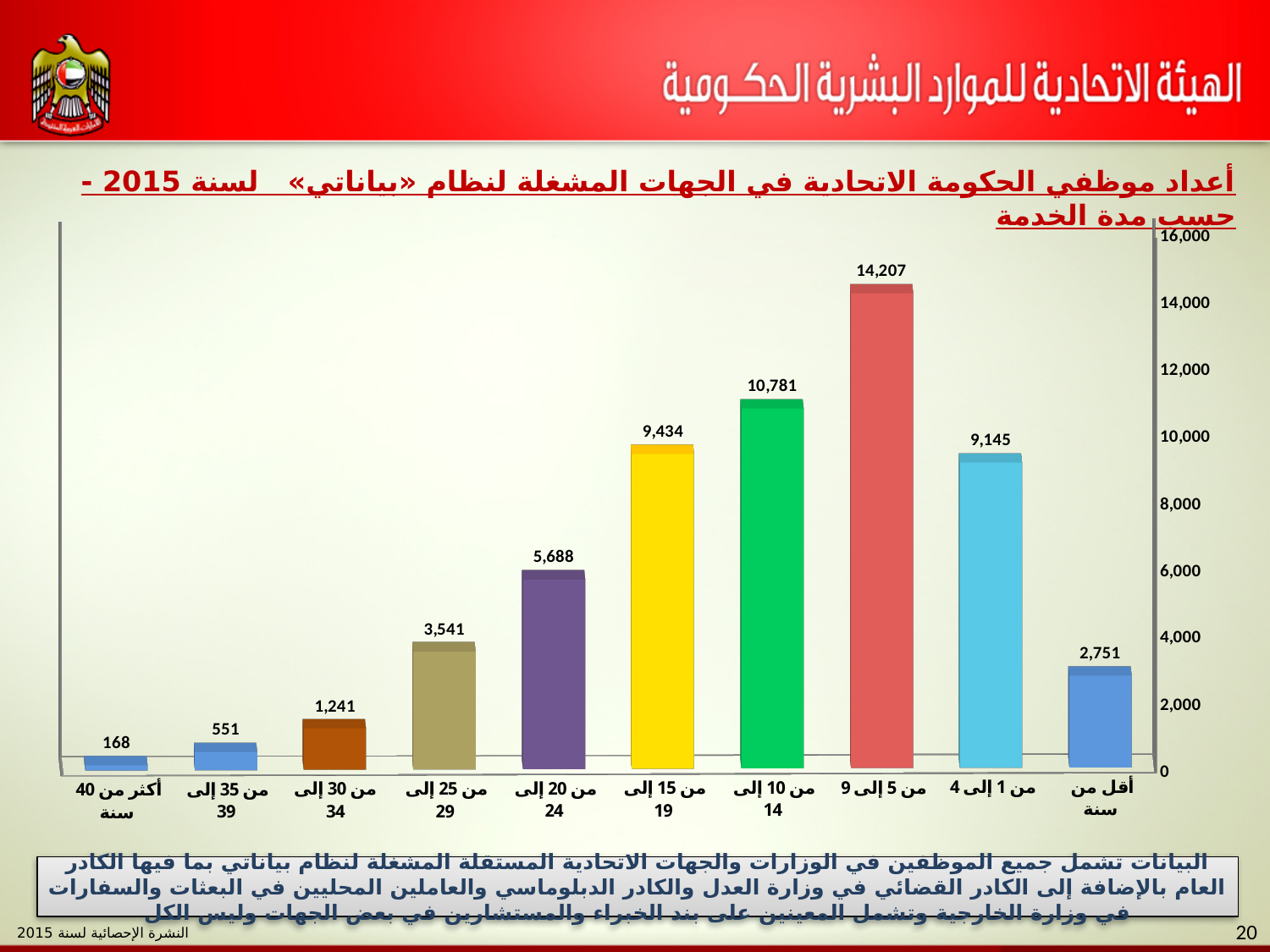
What is the difference between the values for "من 35 إلى 39" and "أكثر من 40 سنة"? 383 Which category has the lowest value? أكثر من 40 سنة Which is larger, the value for "من 1 إلى 4" or the value for "من 15 إلى 19"? من 15 إلى 19 What kind of chart is shown on the slide? bar chart How many categories are shown on the x axis? 10 What is the value for the category "من 30 إلى 34"? 1,241 What is the maximum value shown on the vertical axis? 16,000 What is the value for the category "من 5 إلى 9"? 14,207 What is the value for the category "أقل من سنة"? 2,751 Is the value for "من 20 إلى 24" greater or less than 6,000? less Which category has the highest value? من 5 إلى 9 What is the difference between the values for "من 10 إلى 14" and "من 15 إلى 19"? 1,347